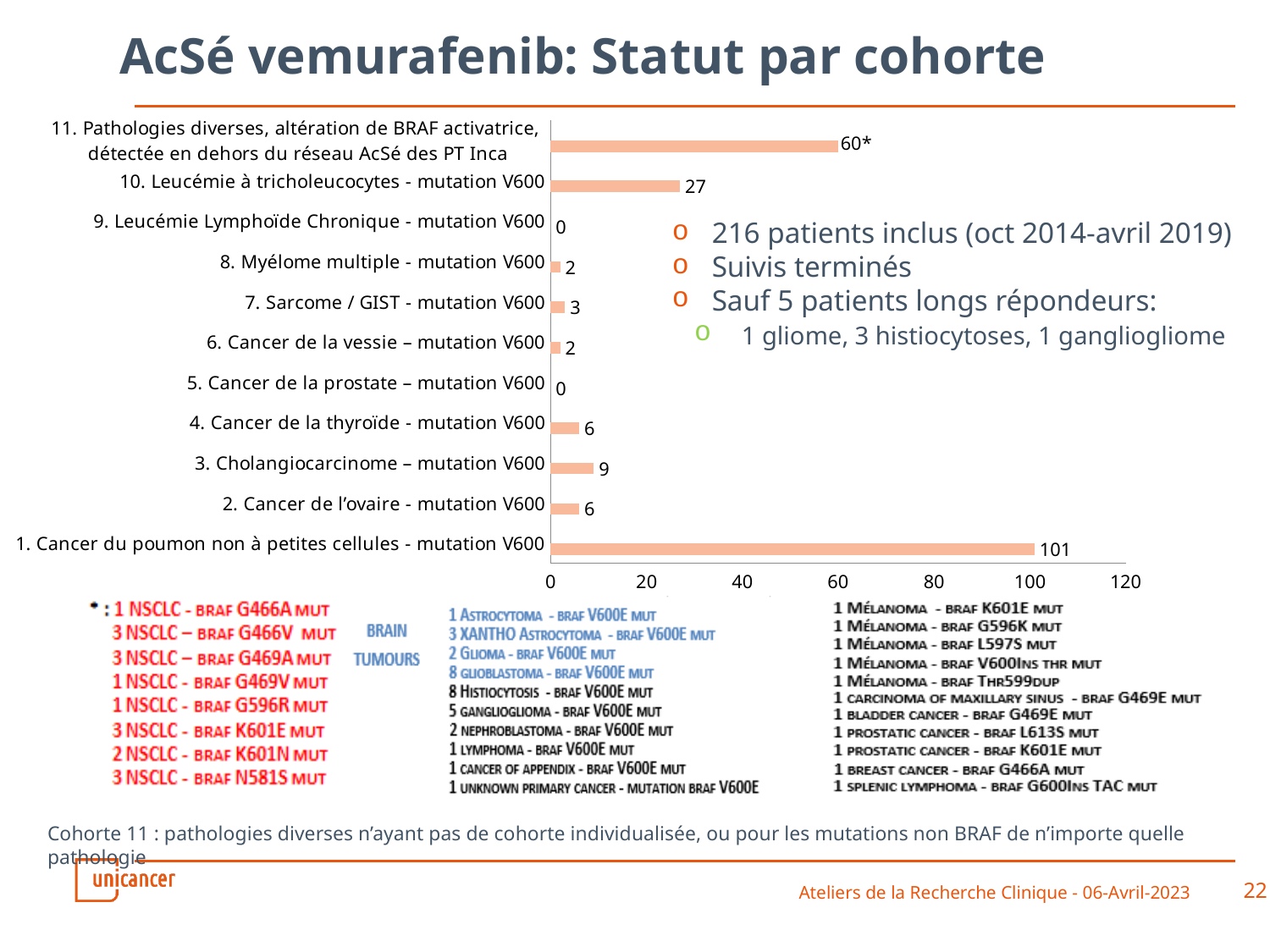
What is the difference between the value for cohort 1 (Cancer du poumon non à petites cellules) and cohort 10 (Leucémie à tricholeucocytes)? 74 What is the value for cohort 10, Leucémie à tricholeucocytes - mutation V600? 27 How many cohorts (categories) are plotted in the bar chart? 11 Which cohorts have a value of 0 in the chart? 9. Leucémie Lymphoïde Chronique and 5. Cancer de la prostate What is the value for cohort 7, Sarcome / GIST - mutation V600? 3 Which is larger: the value for cohort 3 (Cholangiocarcinome) or cohort 4 (Cancer de la thyroïde)? 3. Cholangiocarcinome – mutation V600 What is the value for cohort 3, Cholangiocarcinome – mutation V600? 9 What kind of chart is shown on the slide? bar chart Is the value for cohort 11 (Pathologies diverses) greater or less than 40? greater What is the value for cohort 1, Cancer du poumon non à petites cellules - mutation V600? 101 Which cohort has the highest value in the chart? 1. Cancer du poumon non à petites cellules - mutation V600 What is the maximum value shown on the horizontal axis of the chart? 120